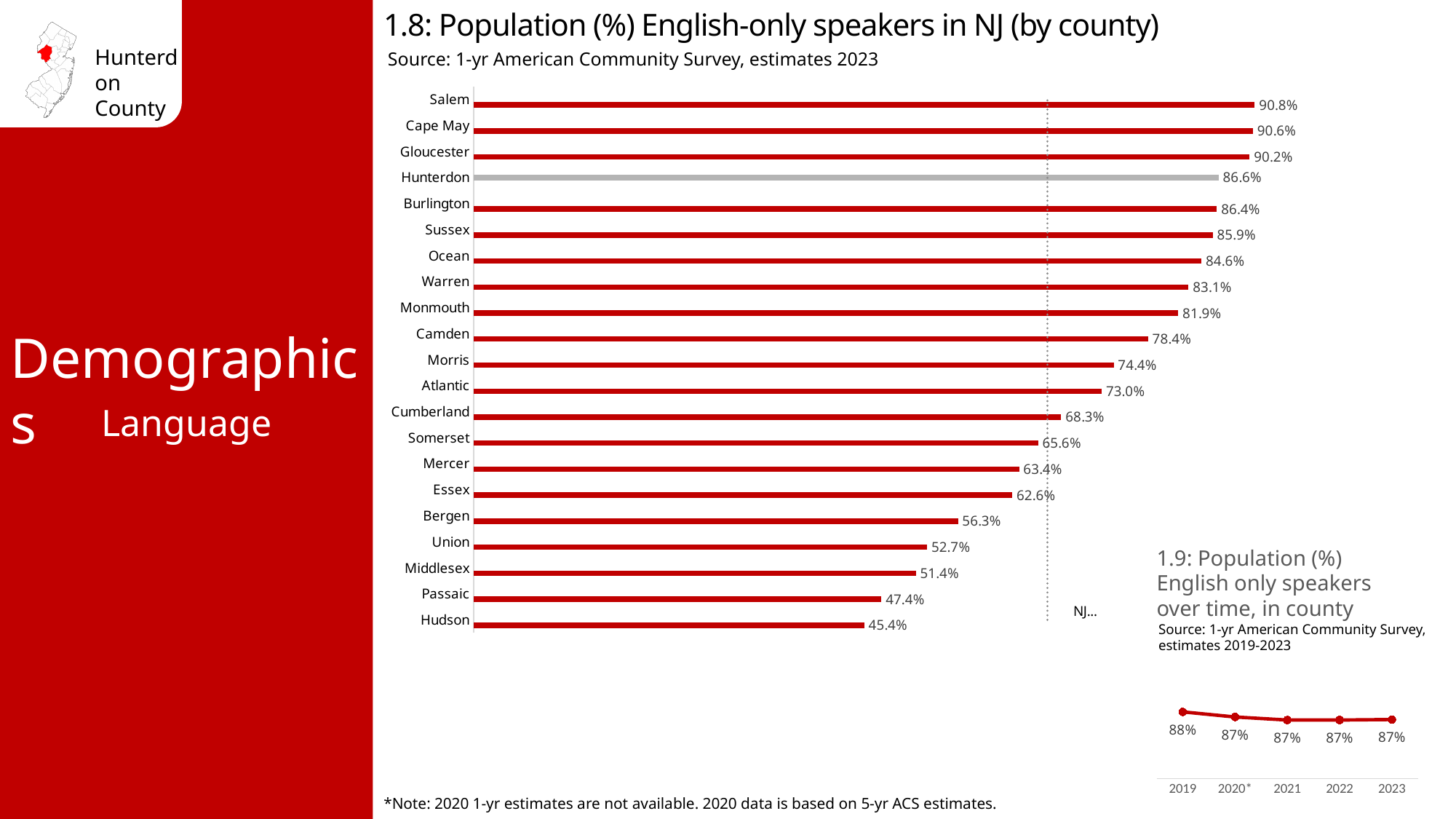
In chart 1.8, which has a larger value, Morris or Camden? Camden In chart 1.9, how many years are plotted? 5 In chart 1.8, what is the value for Hudson? 45.4% In chart 1.8, what is the difference between the values for Hunterdon and Burlington? 0.2% In chart 1.8, what is the value for Hunterdon? 86.6% In chart 1.8, what is the difference between the values for Salem and Hudson? 45.4% In chart 1.8, which county has the highest percentage of English-only speakers? Salem In chart 1.9, do the values rise or fall from 2019 to 2023? fall What kind of chart is chart 1.8? bar chart In chart 1.8, which county has the lowest percentage of English-only speakers? Hudson In chart 1.9, what is the value for 2019? 88% In chart 1.8, how many counties are shown? 21